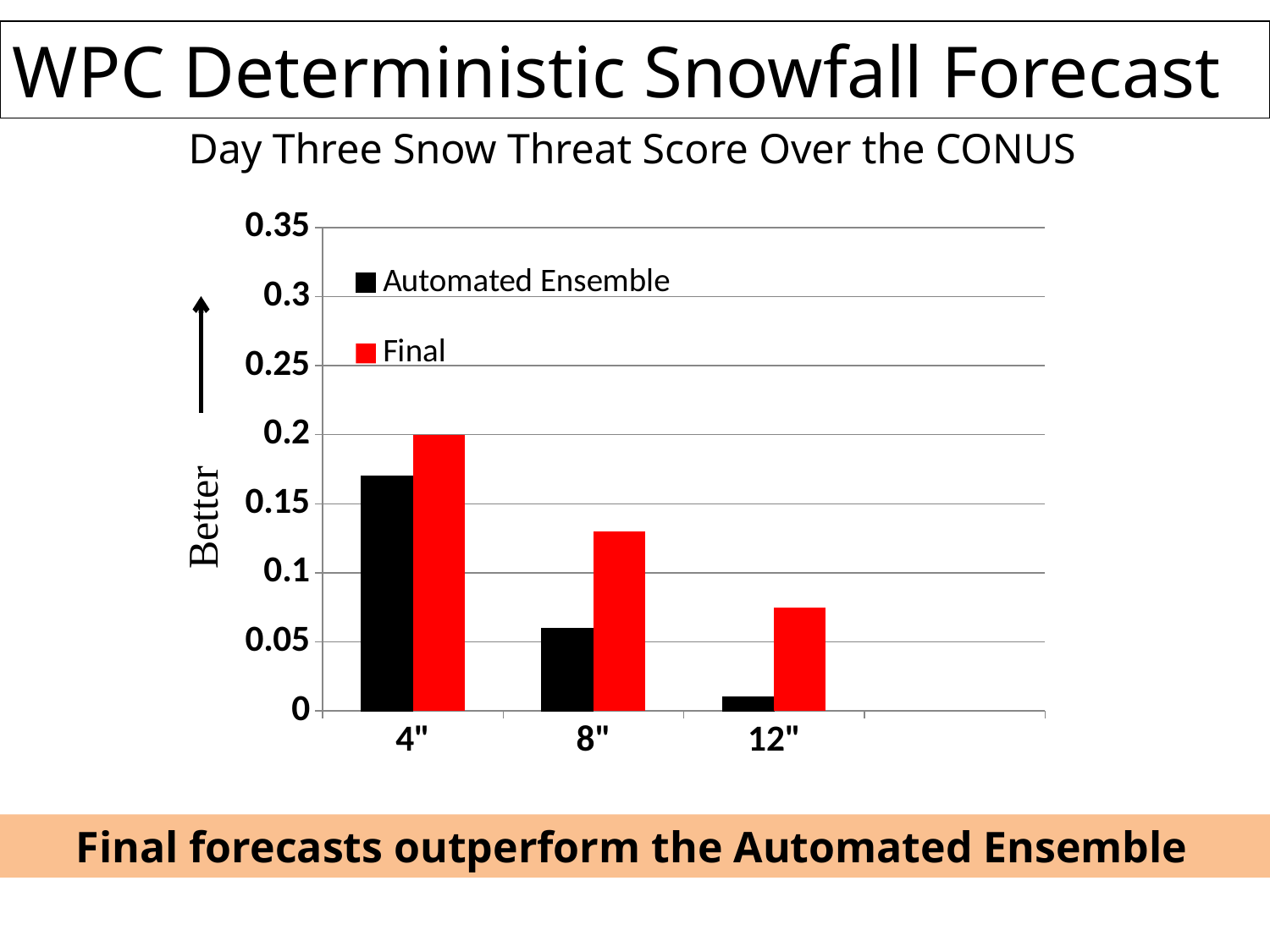
Is the Automated Ensemble value for 12" greater or less than 0.05? less Which colour represents the Final series in the legend? red How many series does the legend list? 2 Do the Final threat scores rise or fall as the snowfall threshold increases from 4" to 12"? fall Is the Automated Ensemble value for 4" greater or less than 0.15? greater What is the Final threat score for the 4" category? 0.2 What kind of chart is shown on the slide? bar chart For the 8" category, which series has the larger threat score, Automated Ensemble or Final? Final Which category has the highest Final threat score? 4" Which category has the lowest Automated Ensemble threat score? 12" Is the Final value for 8" greater or less than 0.1? greater How many snowfall threshold categories are shown on the x axis? 3